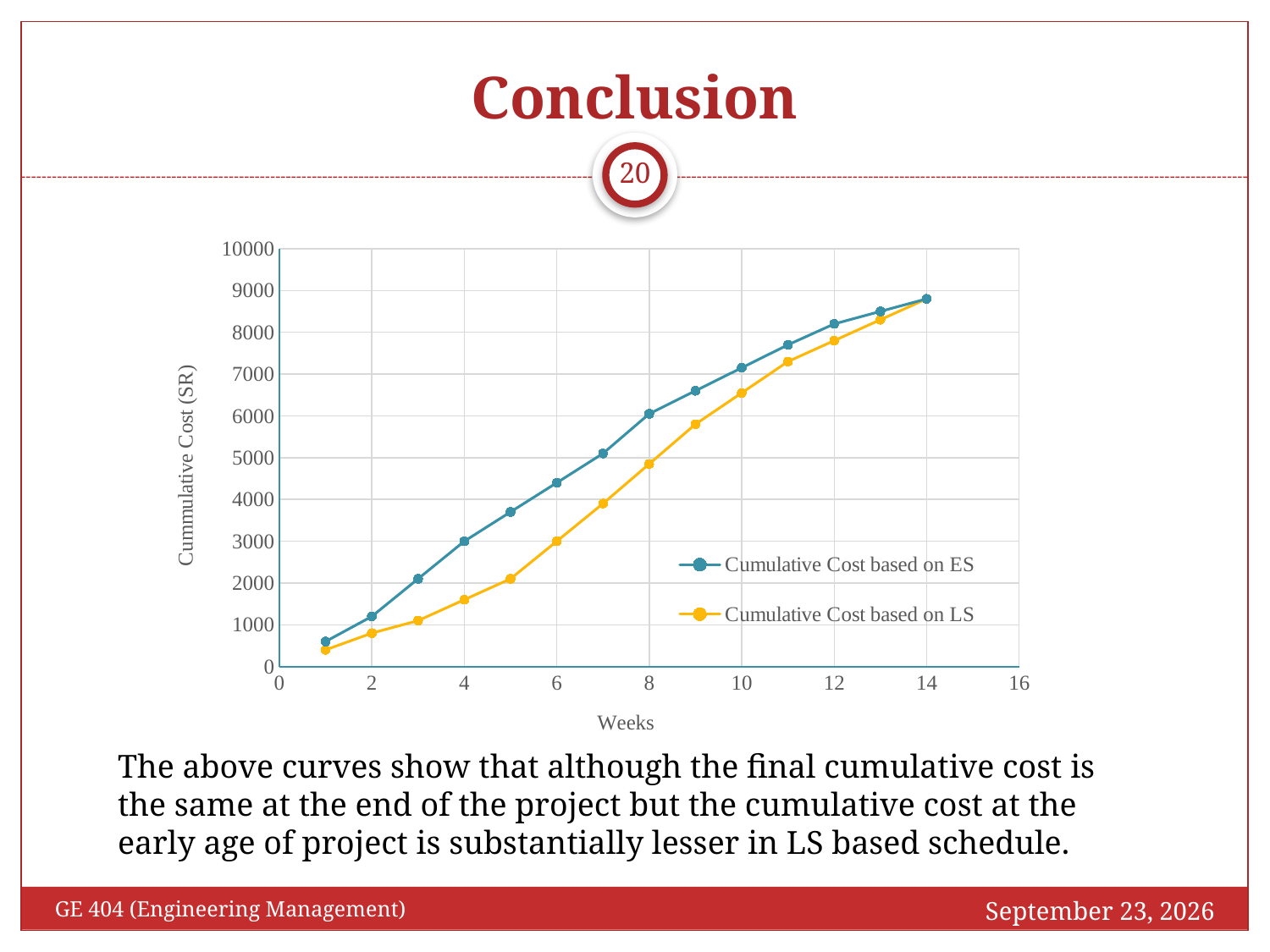
Is the value for Cumulative Cost based on LS at week 10 greater or less than 7000? less At week 8, which series has the larger value: Cumulative Cost based on ES or Cumulative Cost based on LS? Cumulative Cost based on ES Is the value for Cumulative Cost based on ES at week 12 greater or less than 8000? greater What is the label on the x axis of the chart? Weeks At which week does the Cumulative Cost based on LS series reach its highest value? 14 How many data points are plotted for the Cumulative Cost based on ES series? 14 Is the value for Cumulative Cost based on ES at week 8 greater or less than 5000? greater Do the cumulative cost values rise or fall as the weeks increase? rise What kind of chart is shown on the slide? line chart What is the label on the y axis of the chart? Cummulative Cost (SR) How many series does the legend list? 2